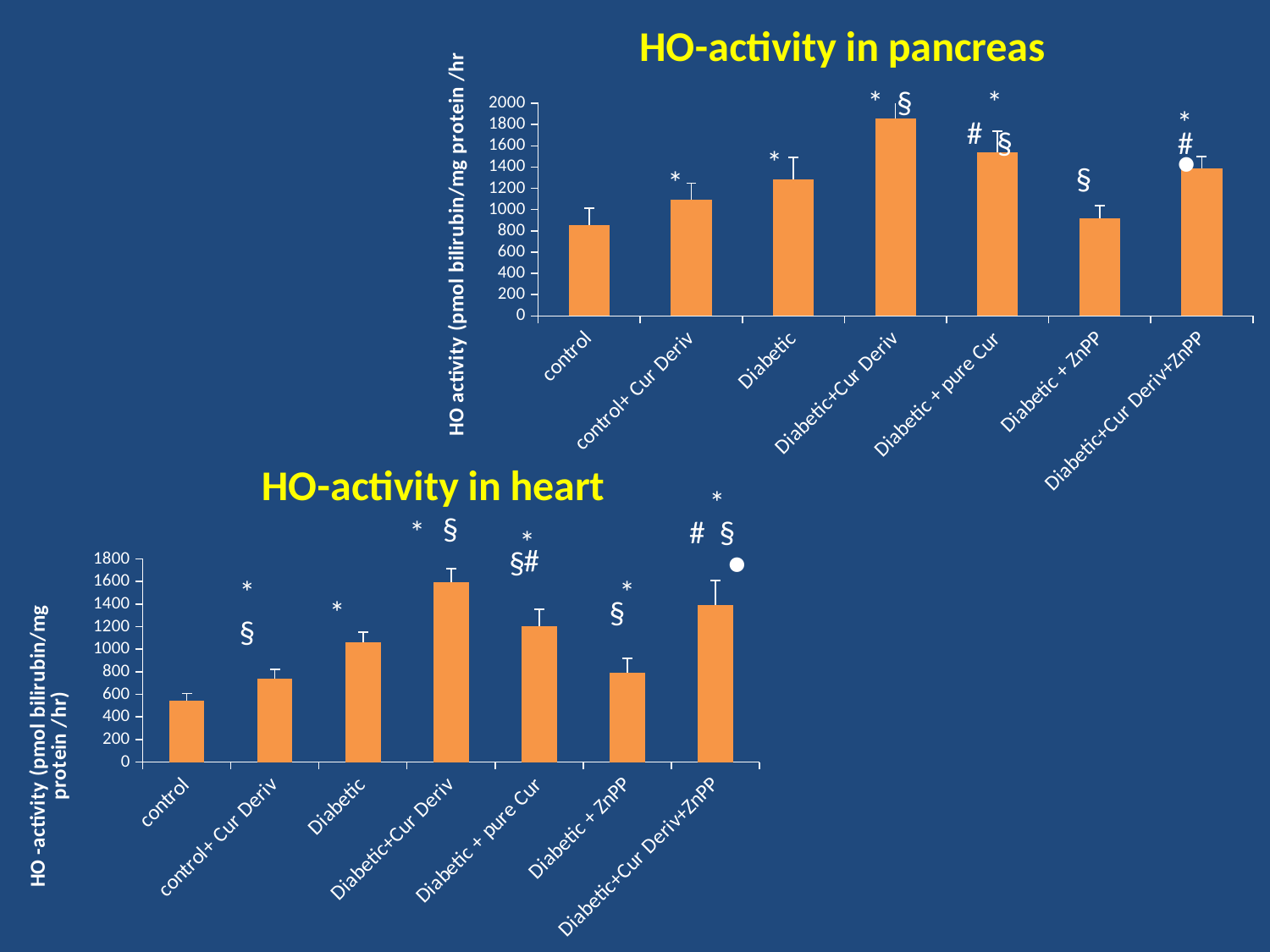
In the HO-activity in pancreas chart, is the value for Diabetic + ZnPP greater or less than 1200? less What kind of chart is the HO-activity in heart chart? bar chart In the HO-activity in heart chart, is the value for Diabetic + pure Cur greater or less than 1000? greater In the HO-activity in heart chart, is the value for control greater or less than 600? less In the HO-activity in pancreas chart, which is larger, Diabetic + pure Cur or Diabetic? Diabetic + pure Cur How many categories are shown in the HO-activity in pancreas chart? 7 In the HO-activity in heart chart, which category has the lowest value? control In the HO-activity in pancreas chart, which category has the highest value? Diabetic+Cur Deriv In the HO-activity in heart chart, which is larger, Diabetic + ZnPP or Diabetic+Cur Deriv+ZnPP? Diabetic+Cur Deriv+ZnPP In the HO-activity in heart chart, which category has the highest value? Diabetic+Cur Deriv